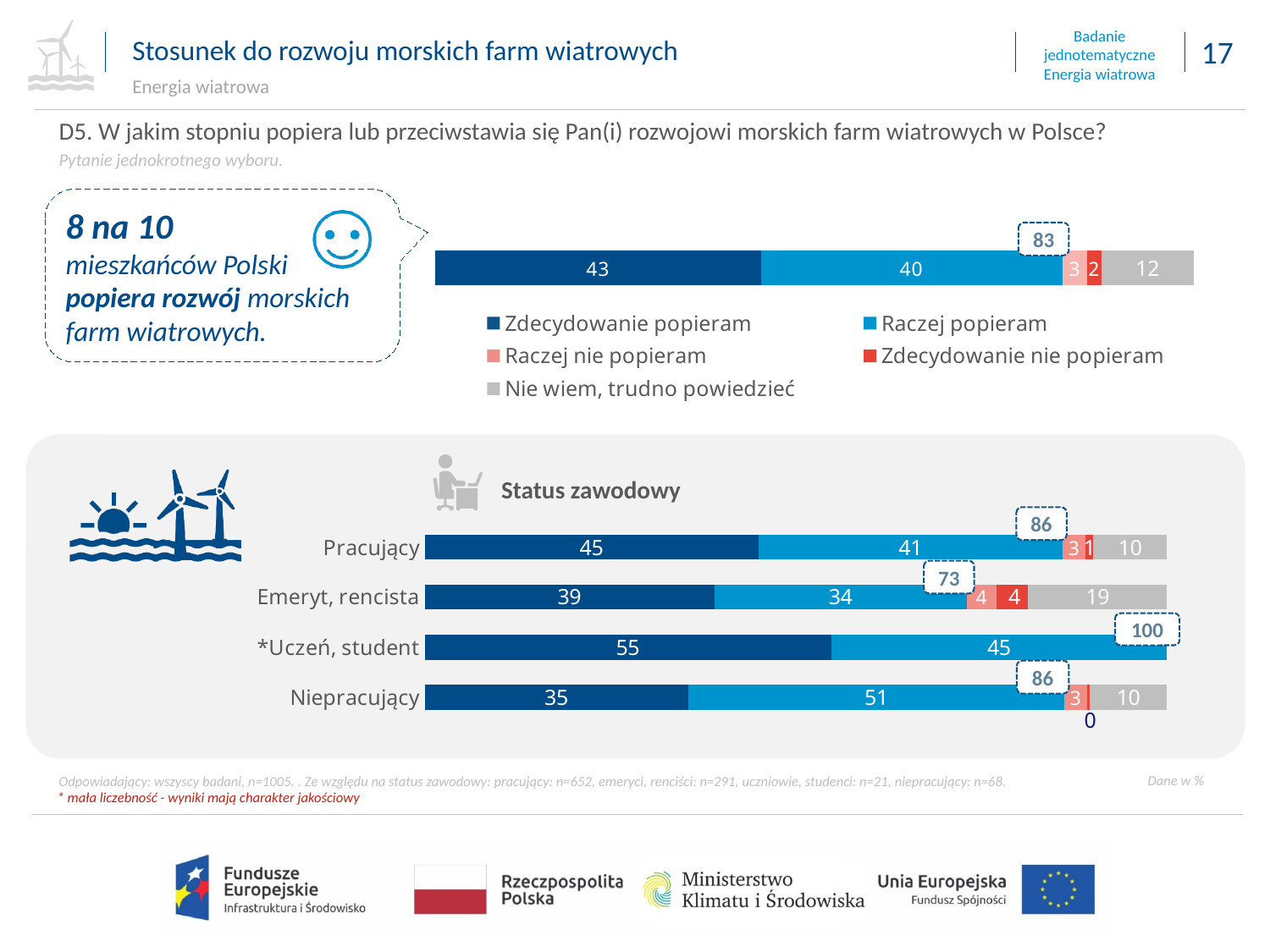
In the "Status zawodowy" chart, which category has the highest "Zdecydowanie popieram" value? *Uczeń, student In the top chart, what is the value for "Zdecydowanie popieram"? 43 In the "Status zawodowy" chart, what is the difference between the "Nie wiem, trudno powiedzieć" values for "Emeryt, rencista" and "Pracujący"? 9 In the "Status zawodowy" chart, what is the "Zdecydowanie popieram" value for "Emeryt, rencista"? 39 In the "Status zawodowy" chart, which is larger: the "Raczej popieram" value for "Pracujący" or for "Emeryt, rencista"? Pracujący How many categories are shown in the "Status zawodowy" chart? 4 In the "Status zawodowy" chart, which category has the lowest "Zdecydowanie popieram" value? Niepracujący In the "Status zawodowy" chart, what is the total of "Zdecydowanie popieram" and "Raczej popieram" for "Emeryt, rencista", as shown in the callout? 73 How many series does the legend of the top chart list? 5 What kind of chart is the top chart? stacked bar chart In the top chart, what is the value for "Nie wiem, trudno powiedzieć"? 12 In the "Status zawodowy" chart, what is the "Raczej popieram" value for "Niepracujący"? 51